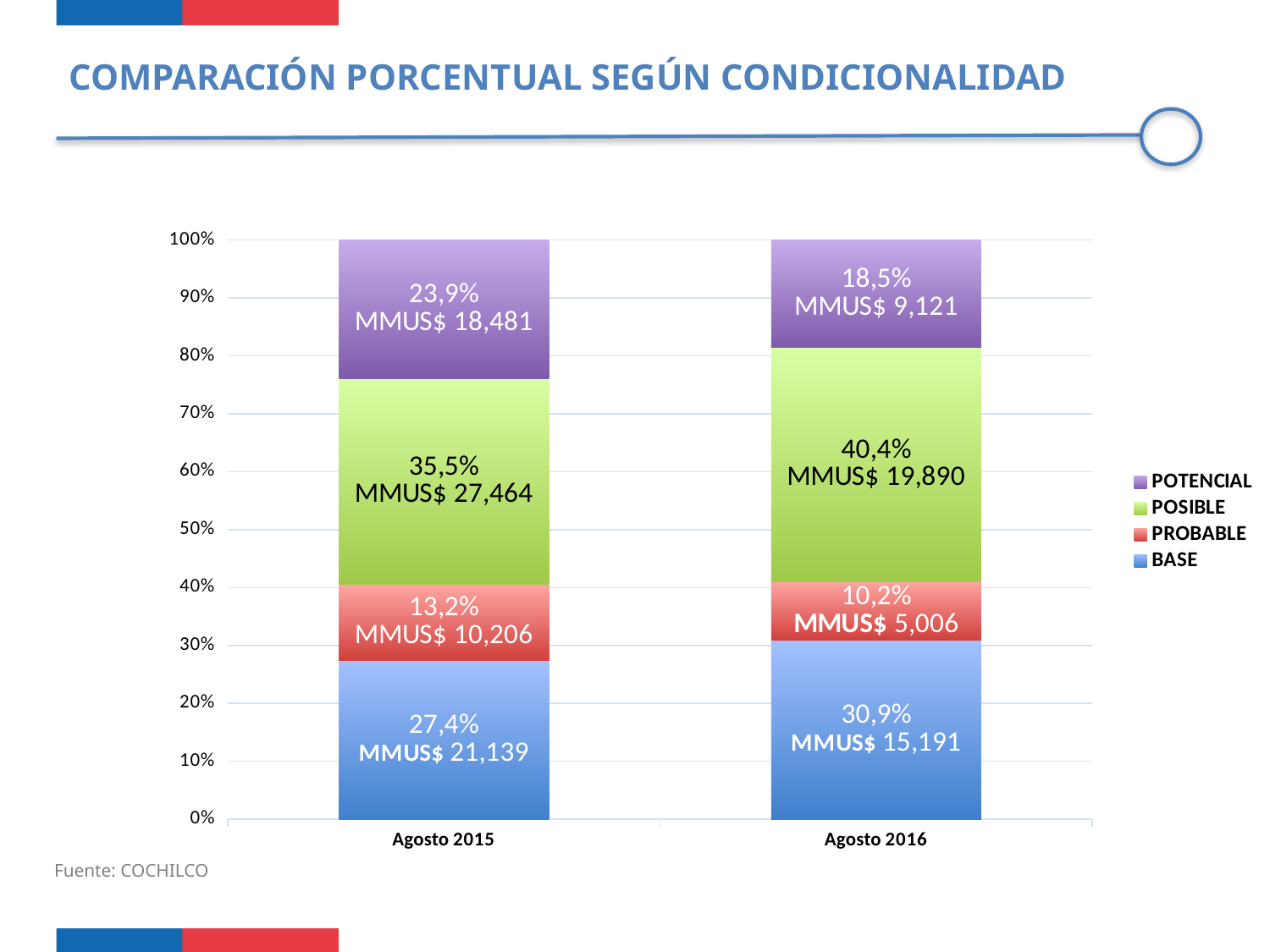
What kind of chart is shown on the slide? Stacked bar chart How many categories are shown on the x axis? 2 How many series does the legend list? 4 Which series has the smallest share in the Agosto 2016 bar? PROBABLE What is the MMUS$ value of the BASE segment for Agosto 2015? MMUS$ 21,139 Which series has the largest share in the Agosto 2015 bar? POSIBLE Does the POTENCIAL share rise or fall from Agosto 2015 to Agosto 2016? Fall Which is larger, the BASE share in Agosto 2015 or in Agosto 2016? Agosto 2016 What percentage does the POSIBLE segment represent in Agosto 2016? 40,4% What is the total MMUS$ value of all four segments in the Agosto 2016 bar? MMUS$ 49,208 What is the MMUS$ value of the POTENCIAL segment for Agosto 2016? MMUS$ 9,121 By how many percentage points did the POSIBLE share change from Agosto 2015 to Agosto 2016? 4,9 percentage points